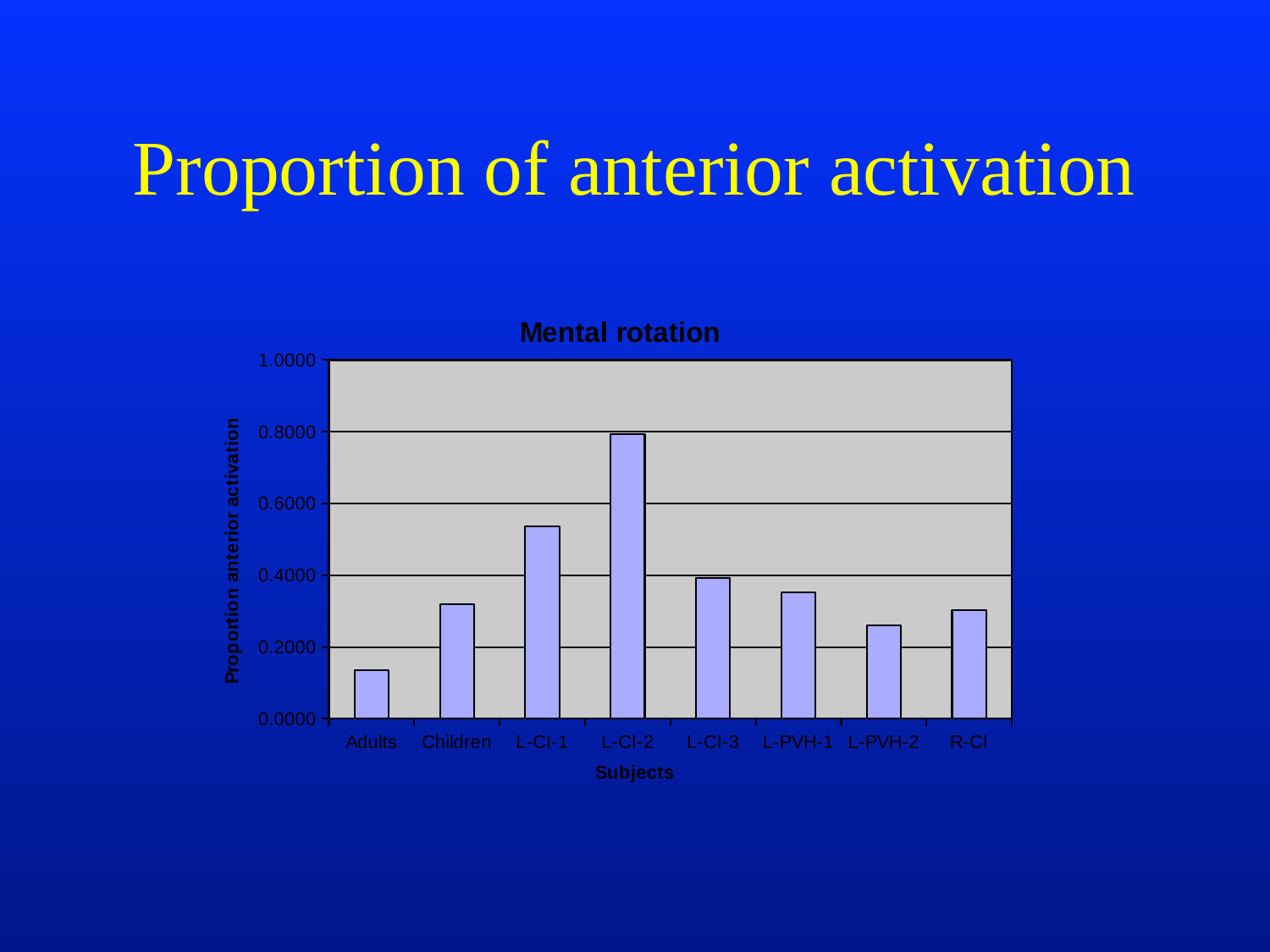
What kind of chart is shown on the slide? bar chart How many subject categories are shown on the x axis of the chart? 8 Is the value for L-CI-1 greater or less than 0.4000? greater Is the value for Adults greater or less than 0.2000? less What is the title of the chart? Mental rotation Which is larger, the value for L-CI-1 or the value for L-CI-3? L-CI-1 Which subject has the lowest proportion of anterior activation? Adults Is the value for L-PVH-2 greater or less than 0.4000? less Which subject has the highest proportion of anterior activation? L-CI-2 What is the label of the x axis of the chart? Subjects Which is larger, the value for Children or the value for Adults? Children